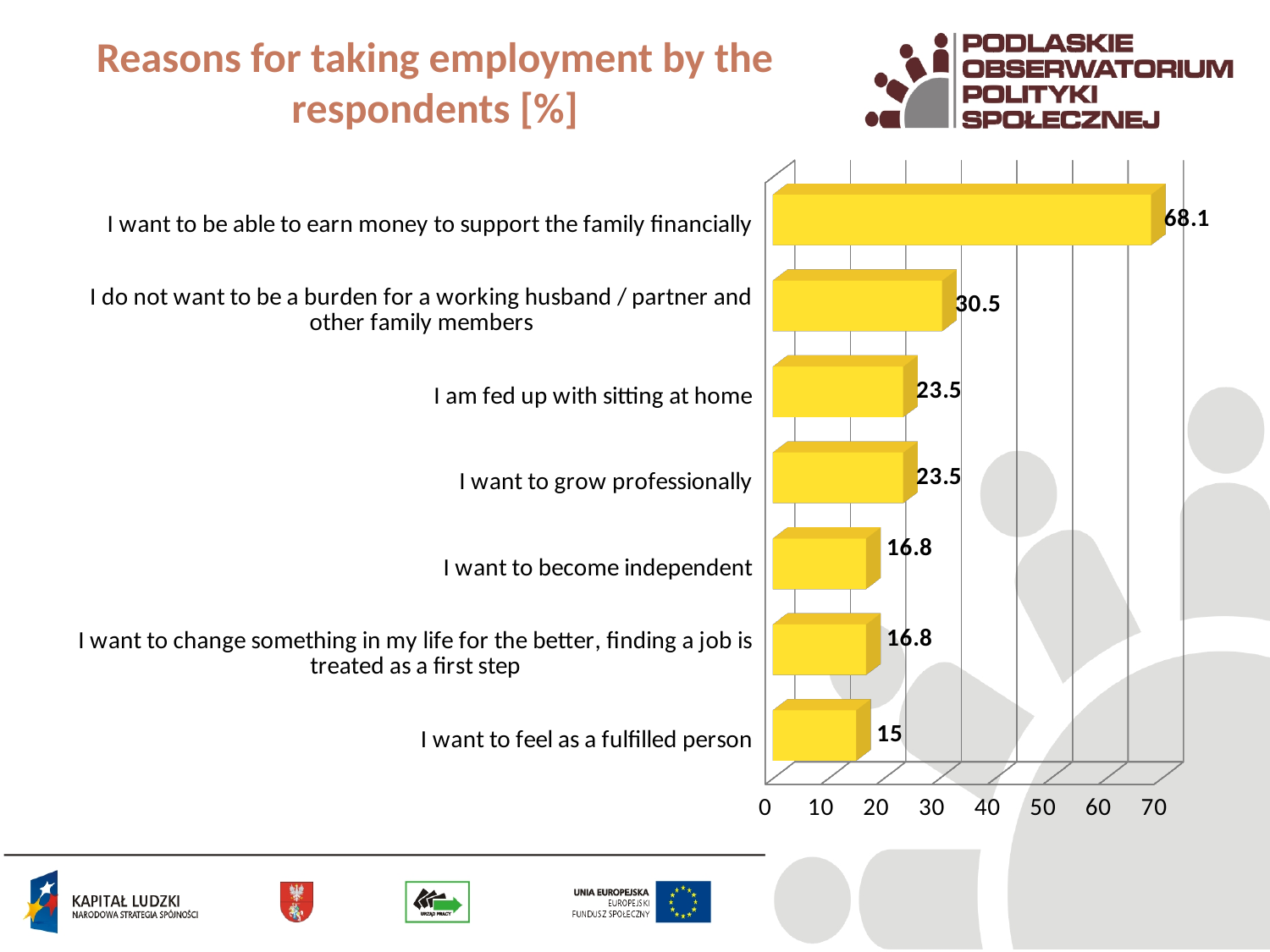
Which reason has the highest value? I want to be able to earn money to support the family financially What is the value for "I want to become independent"? 16.8 Which reason has the lowest value? I want to feel as a fulfilled person What is the value for "I want to be able to earn money to support the family financially"? 68.1 How many reasons (categories) are shown in the chart? 7 What is the difference between the values for "I am fed up with sitting at home" and "I want to feel as a fulfilled person"? 8.5 What is the difference between the values for "I want to be able to earn money to support the family financially" and "I do not want to be a burden for a working husband / partner and other family members"? 37.6 What is the title of the chart on the slide? Reasons for taking employment by the respondents [%] What kind of chart is shown on the slide? Bar chart Which is larger: the value for "I want to grow professionally" or the value for "I want to become independent"? I want to grow professionally What is the value for "I want to feel as a fulfilled person"? 15 What is the value for "I do not want to be a burden for a working husband / partner and other family members"? 30.5